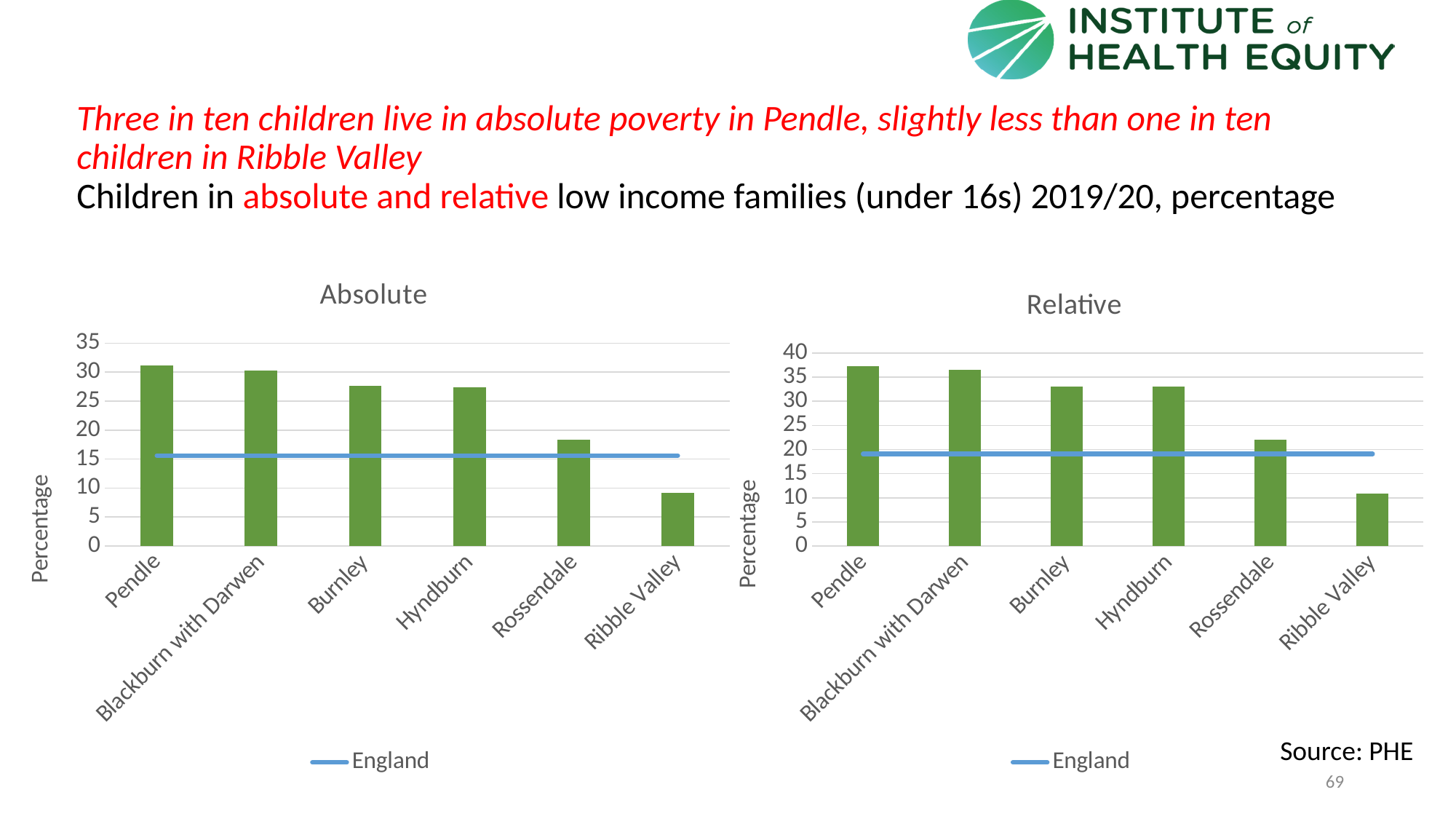
On the Absolute chart, which is larger, the value for Rossendale or the value for Ribble Valley? Rossendale On the Absolute chart, do the bar values rise or fall from left to right? Fall On the Absolute chart, is the value for Hyndburn greater or less than 30? less On the Relative chart, is the value for Pendle greater or less than 35? greater On the Relative chart, is the value for Burnley greater or less than 30? greater On the Relative chart, which area has the lowest value? Ribble Valley What kind of chart is the Absolute chart? Combination bar and line chart On the Absolute chart, which area has the lowest value? Ribble Valley How many areas are shown on the Relative chart? 6